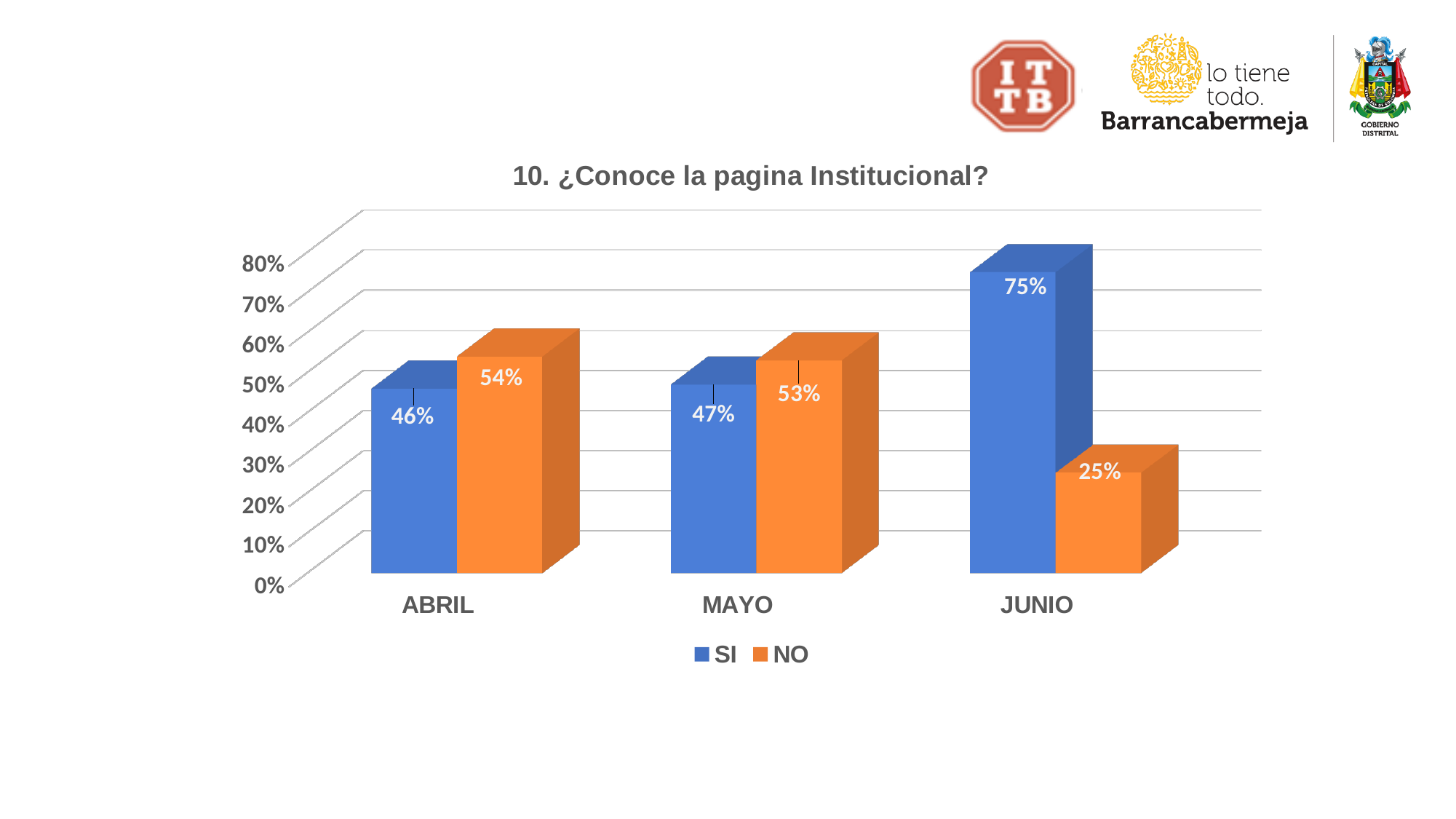
In which month is the NO value lowest? JUNIO How many months are shown on the x axis? 3 What is the title of the chart? 10. ¿Conoce la pagina Institucional? What is the value for NO in JUNIO? 25% What is the value for NO in MAYO? 53% How many series does the legend list? 2 In ABRIL, which is larger, SI or NO? NO What is the value for SI in JUNIO? 75% What kind of chart is shown? bar chart What is the value for SI in ABRIL? 46% What is the difference between the SI and NO values in JUNIO? 50% In which month is the SI value highest? JUNIO